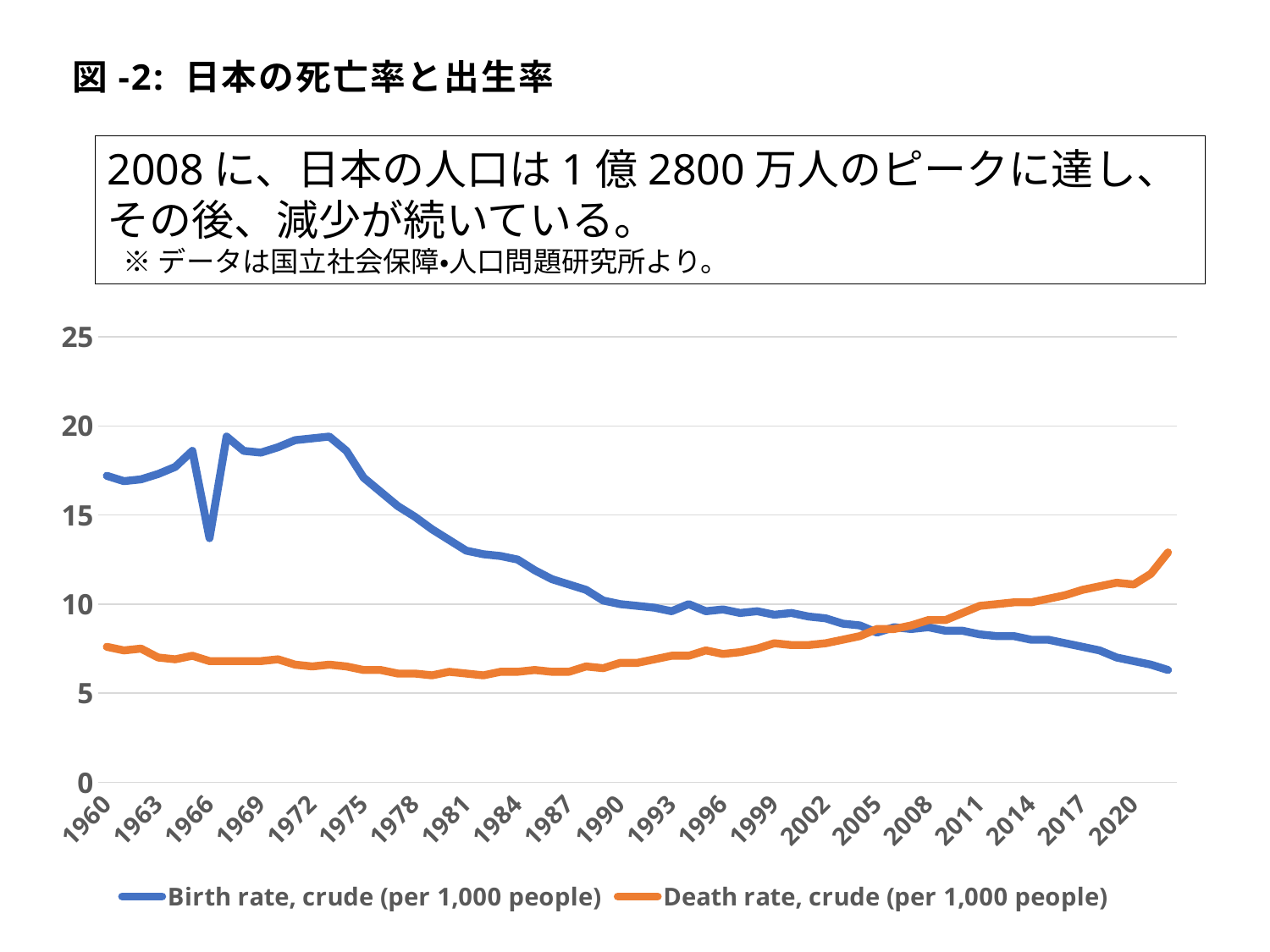
Does the birth rate series rise or fall overall from 1960 to 2020? fall How many series does the legend list? 2 Does the death rate series rise or fall overall from 1960 to 2020? rise In 2020, which is higher: the birth rate or the death rate? Death rate Is the death rate in 2020 greater or less than 10? greater Is the death rate in 1960 greater or less than 10? less Which series is drawn in orange? Death rate, crude (per 1,000 people) Is the birth rate in 2020 greater or less than 10? less In 1960, which is higher: the birth rate or the death rate? Birth rate What kind of chart is shown on the slide? line chart